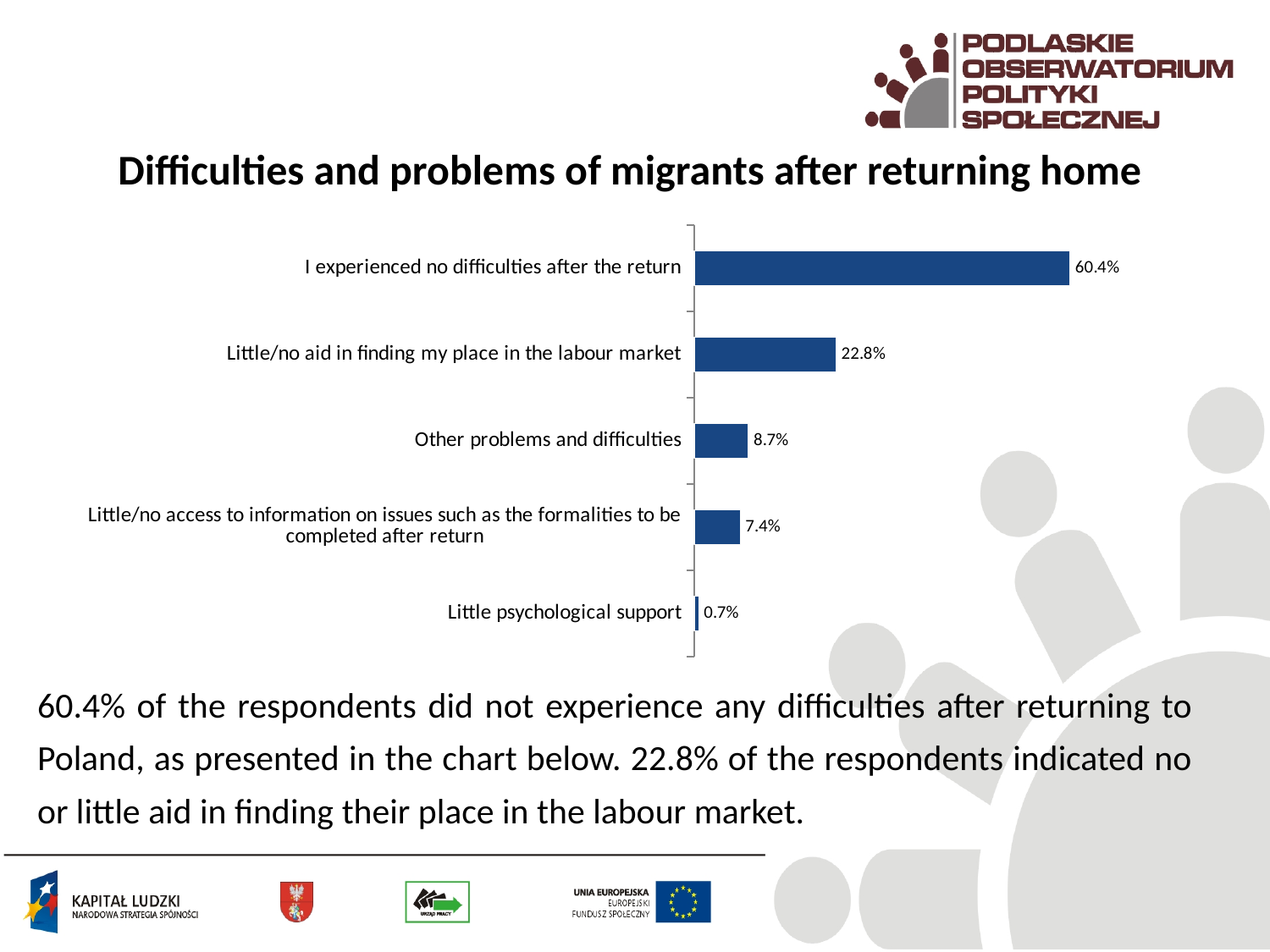
What percentage is shown for 'Other problems and difficulties'? 8.7% How many categories are shown in the chart? 5 What is the difference between 'Other problems and difficulties' and 'Little/no access to information on issues such as the formalities to be completed after return'? 1.3% What is the value for 'Little psychological support'? 0.7% What is the title of the chart? Difficulties and problems of migrants after returning home Which category has the highest value? I experienced no difficulties after the return What percentage of respondents experienced no difficulties after the return? 60.4% Which category has the lowest value? Little psychological support What type of chart is shown on the slide? Bar chart What is the difference between 'I experienced no difficulties after the return' and 'Little/no aid in finding my place in the labour market'? 37.6% Which is larger: 'Other problems and difficulties' or 'Little/no access to information on issues such as the formalities to be completed after return'? Other problems and difficulties What is the value for 'Little/no aid in finding my place in the labour market'? 22.8%